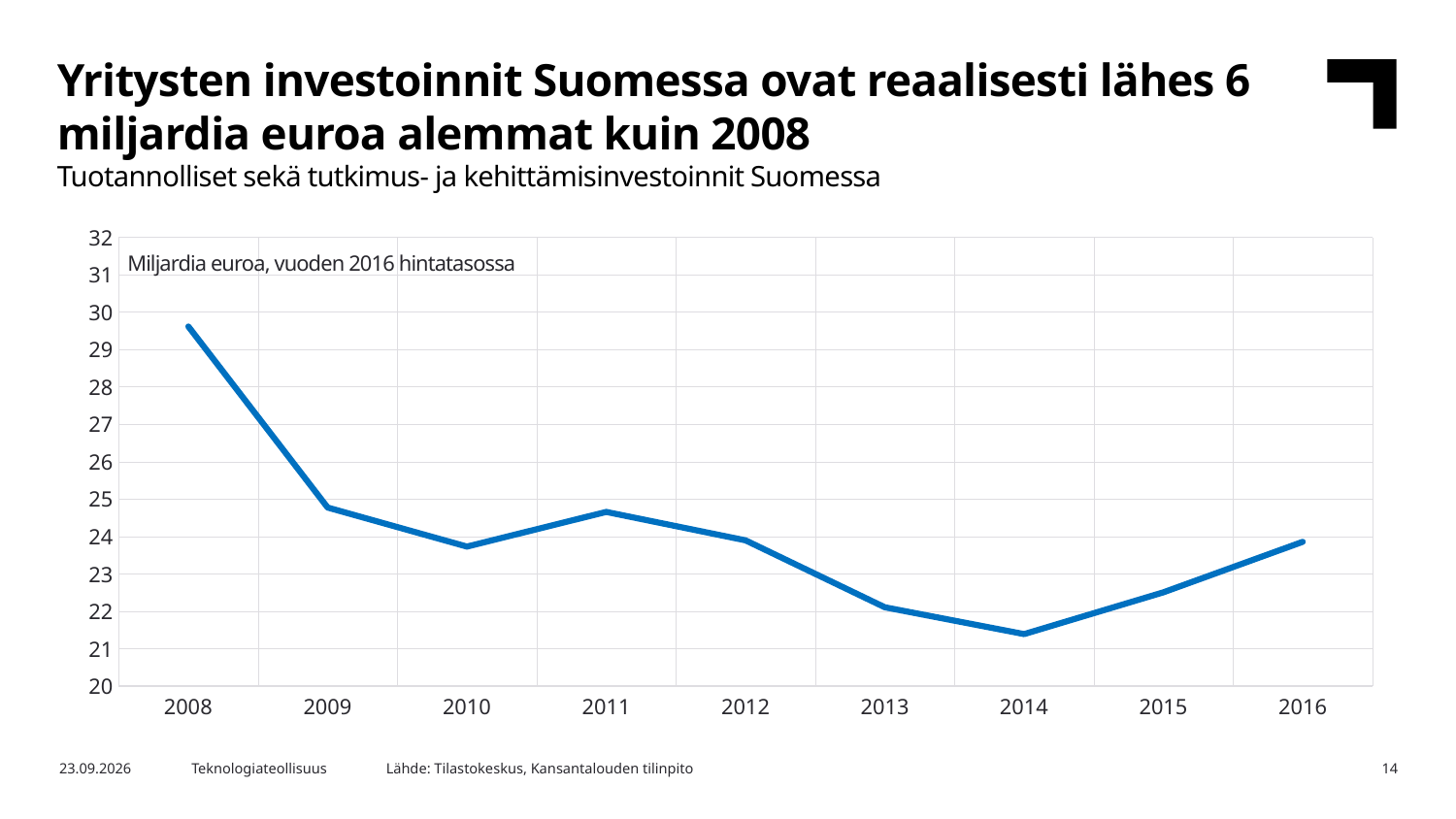
Is the value for 2014 greater or less than 22? less Is the value for 2008 greater or less than 29? greater Which year has the lowest value? 2014 Which is larger, the value for 2009 or the value for 2013? 2009 Is the value for 2011 greater or less than 24? greater Do the values rise or fall from 2008 to 2010? fall Do the values rise or fall from 2014 to 2016? rise What unit note is printed inside the chart area? Miljardia euroa, vuoden 2016 hintatasossa Which year has the highest value? 2008 How many years are plotted along the x axis? 9 What kind of chart is shown on the slide? line chart